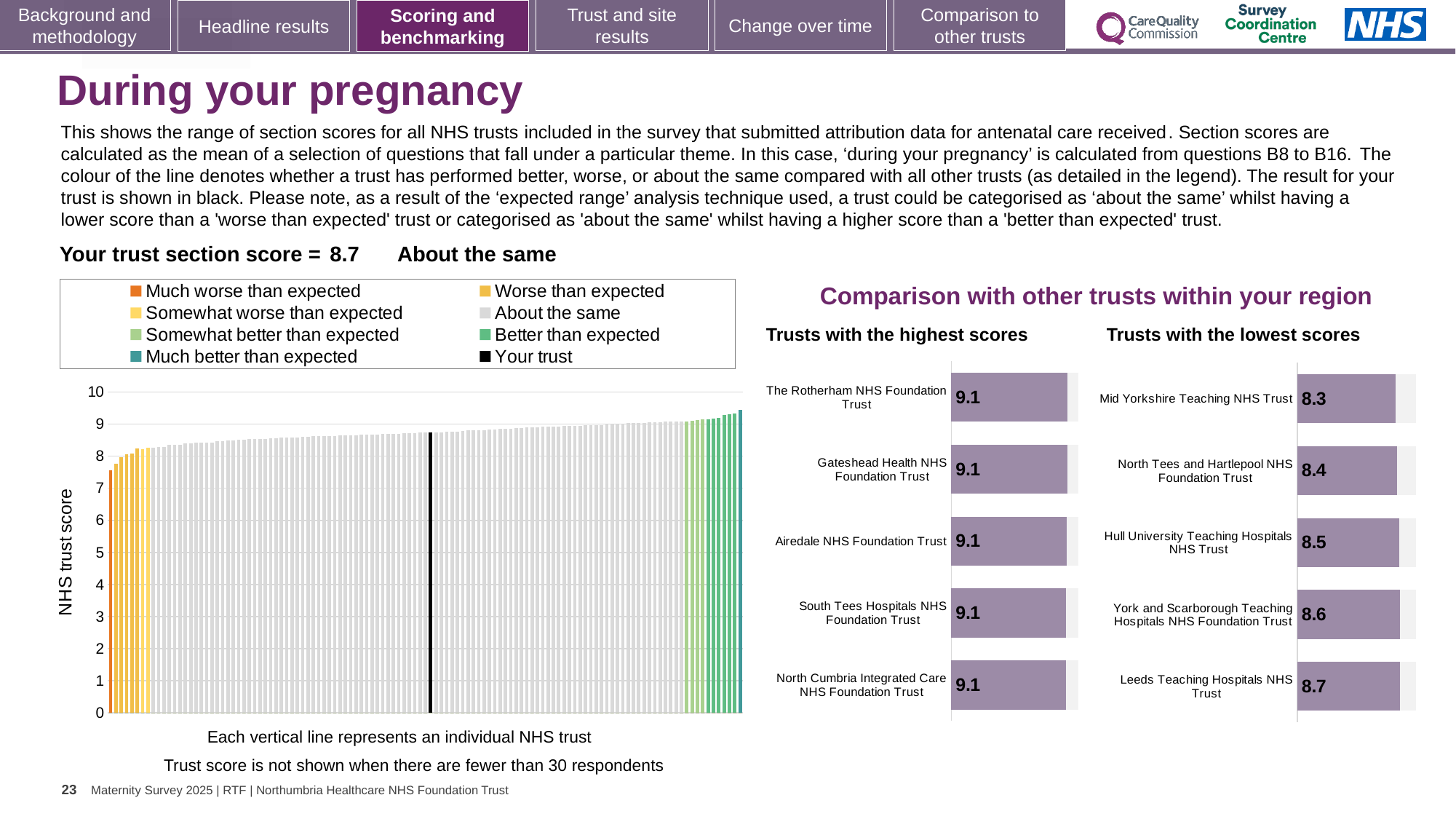
In the 'NHS trust score' chart on the left, is the value of the black 'Your trust' bar greater or less than 8? greater In the 'Trusts with the lowest scores' chart, which trust has the highest score? Leeds Teaching Hospitals NHS Trust In the 'Trusts with the lowest scores' chart, which trust has the lowest score? Mid Yorkshire Teaching NHS Trust In the 'Trusts with the lowest scores' chart, which has the higher score: North Tees and Hartlepool NHS Foundation Trust or York and Scarborough Teaching Hospitals NHS Foundation Trust? York and Scarborough Teaching Hospitals NHS Foundation Trust How many trusts are listed in the 'Trusts with the highest scores' chart? 5 How many entries does the legend of the 'NHS trust score' chart on the left list? 8 In the 'Trusts with the lowest scores' chart, what is the score for Hull University Teaching Hospitals NHS Trust? 8.5 In the 'Trusts with the lowest scores' chart, what is the difference between the scores of Leeds Teaching Hospitals NHS Trust and Mid Yorkshire Teaching NHS Trust? 0.4 In the 'Trusts with the lowest scores' chart, what is the score for Mid Yorkshire Teaching NHS Trust? 8.3 What kind of chart is the 'NHS trust score' chart on the left of the slide? Bar chart In the 'Trusts with the highest scores' chart, what is the score for Airedale NHS Foundation Trust? 9.1 In the 'NHS trust score' chart on the left, do the bar values rise or fall from left to right? Rise